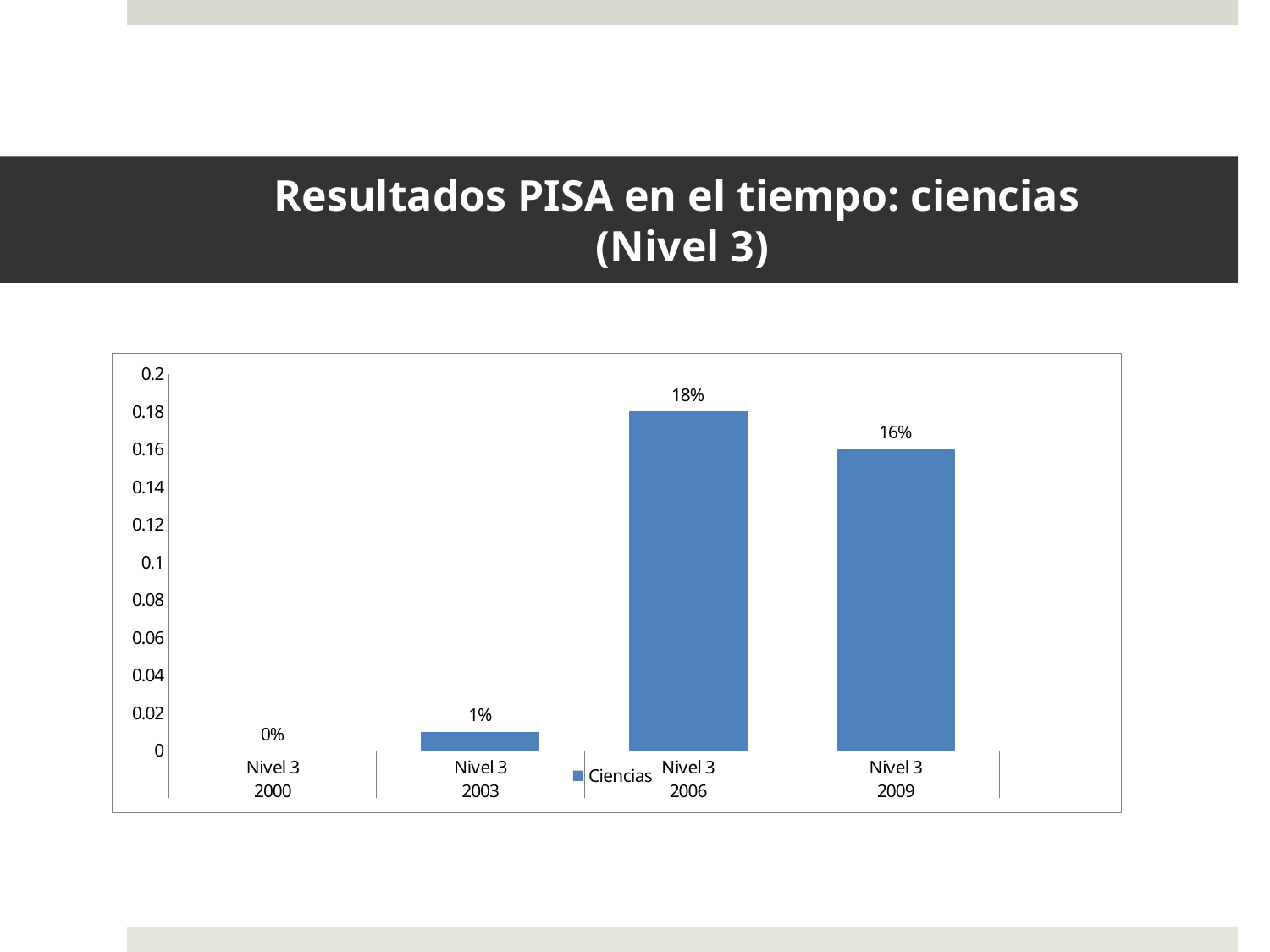
How many categories are shown on the x axis? 4 What is the name of the series shown in the legend? Ciencias What is the value for Nivel 3 2003? 1% Which category has the highest value? Nivel 3 2006 What is the difference between the values for Nivel 3 2006 and Nivel 3 2009? 2% What is the value for Nivel 3 2009? 16% What is the value for Nivel 3 2000? 0% What kind of chart is shown on the slide? Bar chart Which is larger, the value for Nivel 3 2003 or the value for Nivel 3 2009? Nivel 3 2009 Which category has the lowest value? Nivel 3 2000 How many series does the legend list? 1 What is the value for Nivel 3 2006? 18%